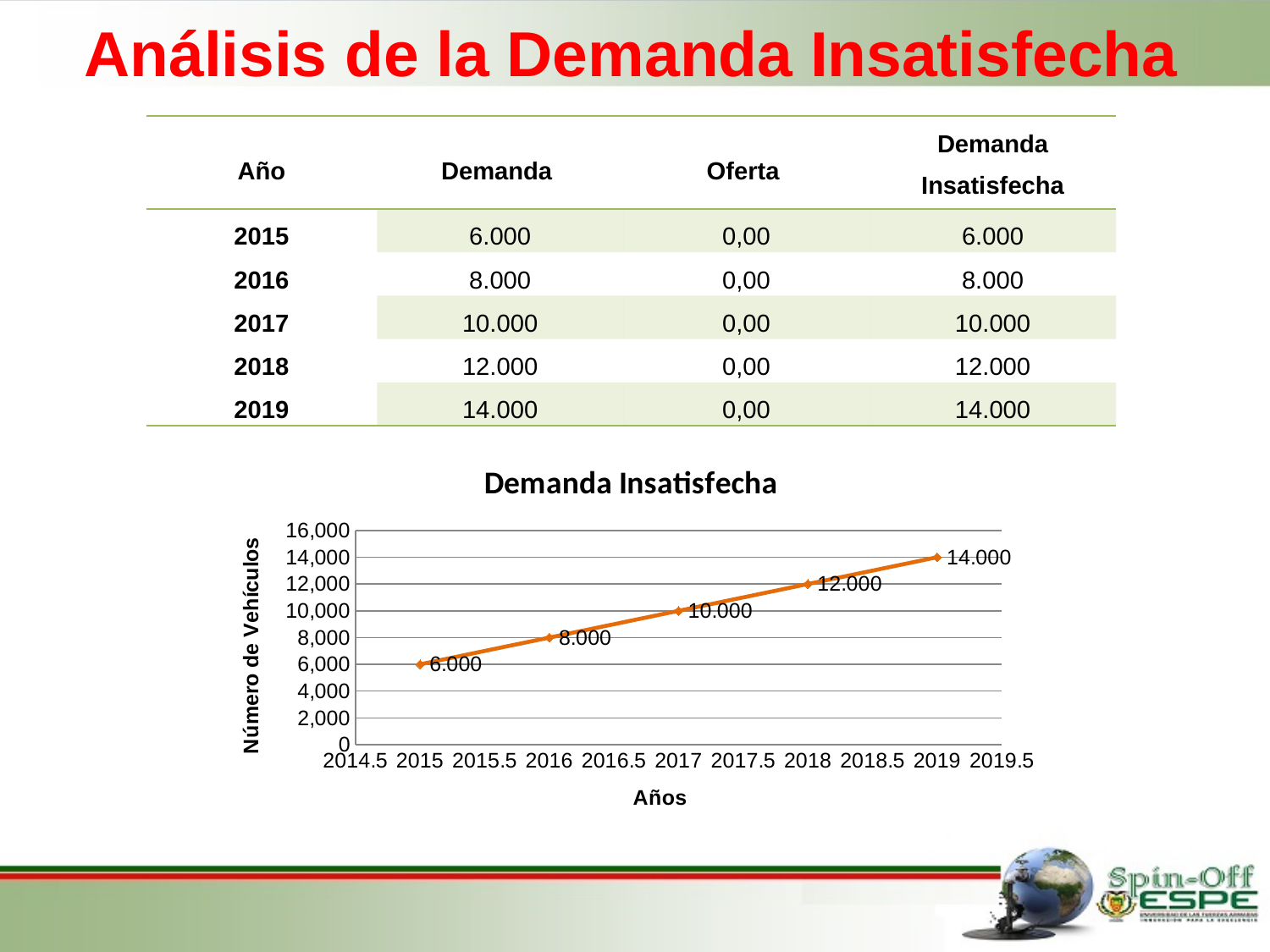
What is the value plotted for 2015 in the Demanda Insatisfecha chart? 6.000 Which is larger in the Demanda Insatisfecha chart, the value for 2016 or the value for 2018? 2018 Which year has the highest value in the Demanda Insatisfecha chart? 2019 How many data points are plotted in the Demanda Insatisfecha chart? 5 What kind of chart is the Demanda Insatisfecha chart? Line chart What is the value plotted for 2019 in the Demanda Insatisfecha chart? 14.000 Do the values in the Demanda Insatisfecha chart rise or fall from 2015 to 2019? Rise Is the value for 2017 in the Demanda Insatisfecha chart greater or less than 8,000? greater Which year has the lowest value in the Demanda Insatisfecha chart? 2015 What is the difference between the values for 2018 and 2016 in the Demanda Insatisfecha chart? 4.000 What is the value plotted for 2017 in the Demanda Insatisfecha chart? 10.000 What is the difference between the values for 2019 and 2015 in the Demanda Insatisfecha chart? 8.000